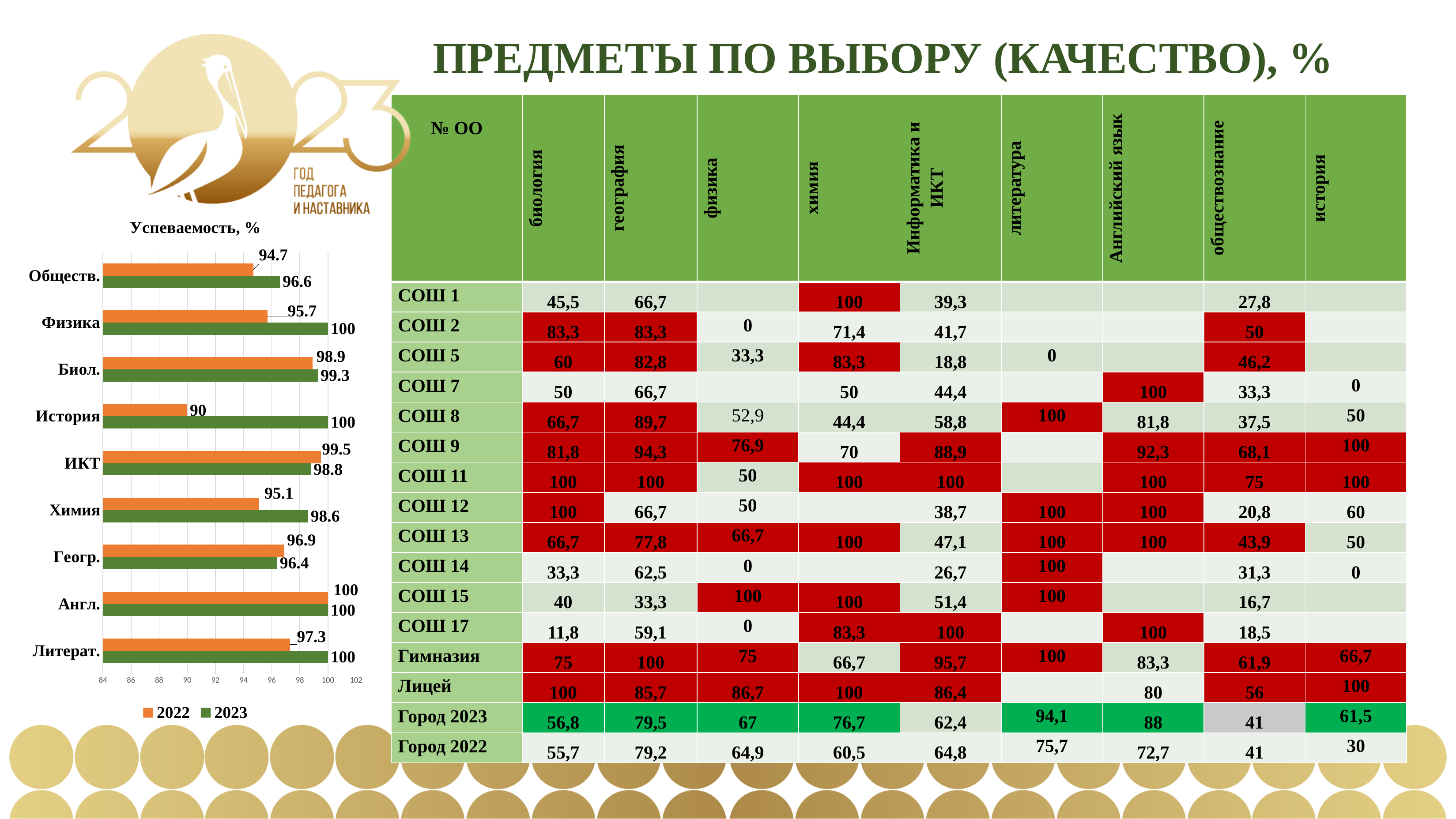
In the "Успеваемость, %" chart, which category has the lowest 2023 value? Геогр. What type of chart is shown under the title "Успеваемость, %"? bar chart In the "Успеваемость, %" chart, what is the 2022 value for История? 90 In the "Успеваемость, %" chart, what is the difference between the 2023 and 2022 values for Химия? 3.5 In the "Успеваемость, %" chart, what is the 2022 value for ИКТ? 99.5 In the "Успеваемость, %" chart, which colour represents the 2023 series? green In the "Успеваемость, %" chart, what is the 2023 value for Химия? 98.6 In the "Успеваемость, %" chart, what is the difference between the 2023 and 2022 values for История? 10 In the "Успеваемость, %" chart, which category has the lowest 2022 value? История How many categories are shown in the "Успеваемость, %" chart? 9 How many series does the legend of the "Успеваемость, %" chart list? 2 In the "Успеваемость, %" chart, which is larger for ИКТ: the 2022 value or the 2023 value? 2022